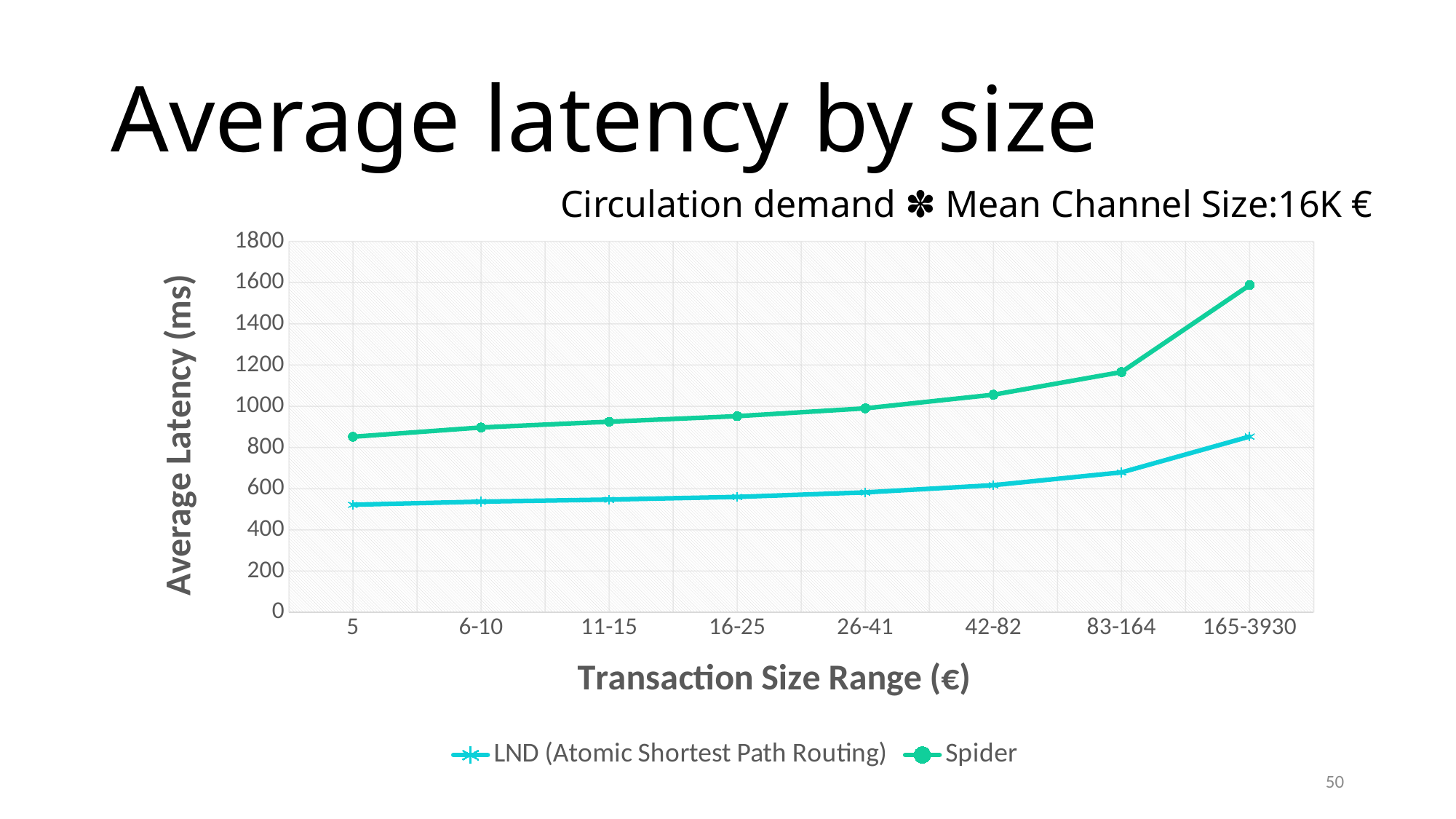
Is the Spider value for the 83-164 range greater or less than 1000? greater What is the label of the y axis? Average Latency (ms) At the 26-41 transaction size range, which series has the higher average latency, LND or Spider? Spider Is the Spider value for the 165-3930 range greater or less than 1400? greater Which transaction size range has the lowest average latency for LND (Atomic Shortest Path Routing)? 5 How many transaction size ranges are shown on the x axis? 8 Is the LND (Atomic Shortest Path Routing) value for the 42-82 range greater or less than 800? less Which transaction size range has the highest average latency for Spider? 165-3930 Do the Spider values rise or fall as the transaction size range increases along the x axis? rise How many series does the legend list? 2 What kind of chart is shown on the slide? line chart